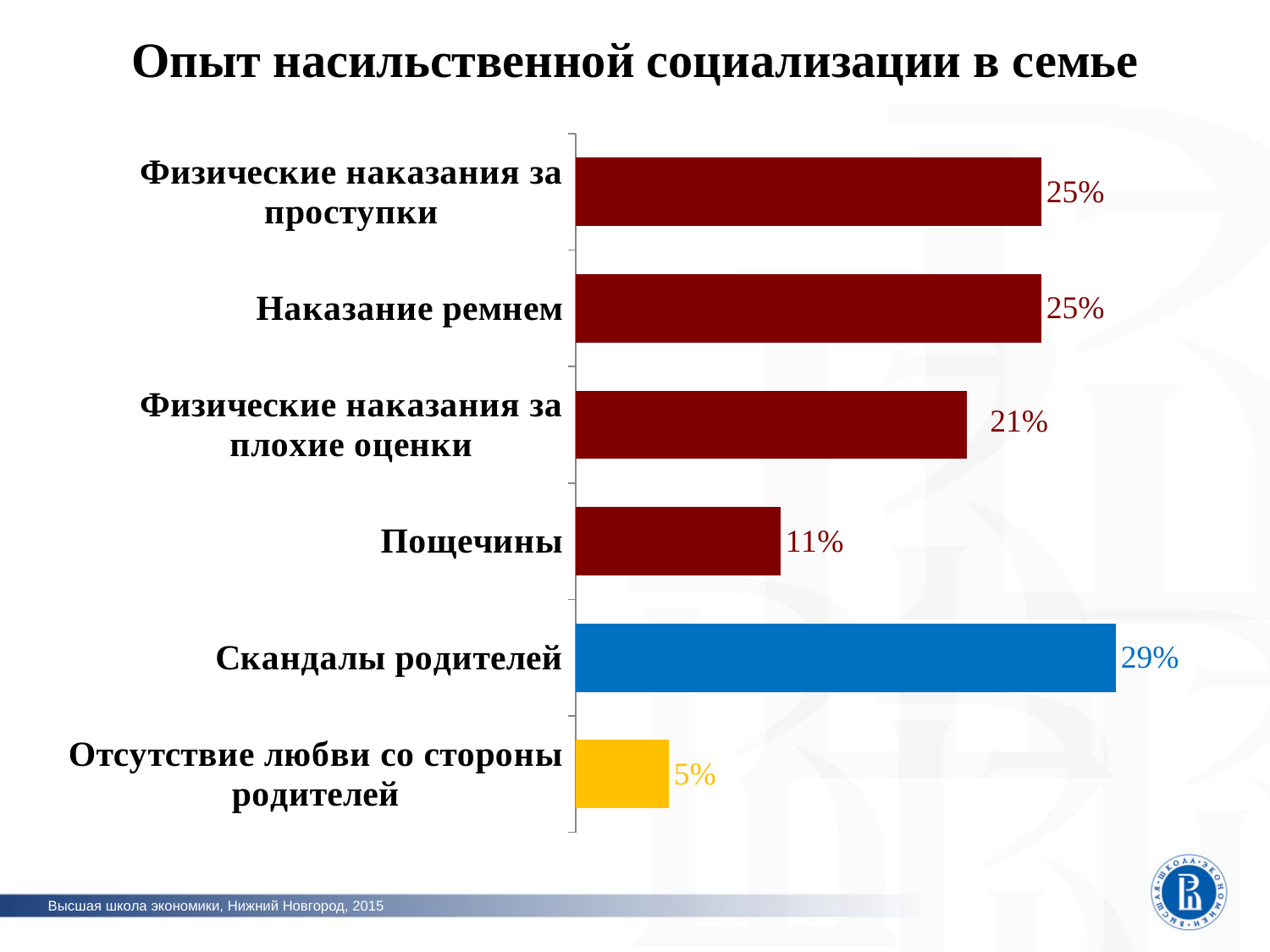
What is the value for Пощечины? 11% How many categories are shown in the chart? 6 What kind of chart is shown on the slide? Bar chart What is the value for Физические наказания за плохие оценки? 21% What is the difference between the values for Скандалы родителей and Пощечины? 18% What is the value for Отсутствие любви со стороны родителей? 5% What is the difference between the values for Наказание ремнем and Физические наказания за плохие оценки? 4% What is the value for Скандалы родителей? 29% What is the title of the slide? Опыт насильственной социализации в семье Which category has the highest value? Скандалы родителей Which is larger, the value for Физические наказания за плохие оценки or the value for Пощечины? Физические наказания за плохие оценки Which category has the lowest value? Отсутствие любви со стороны родителей